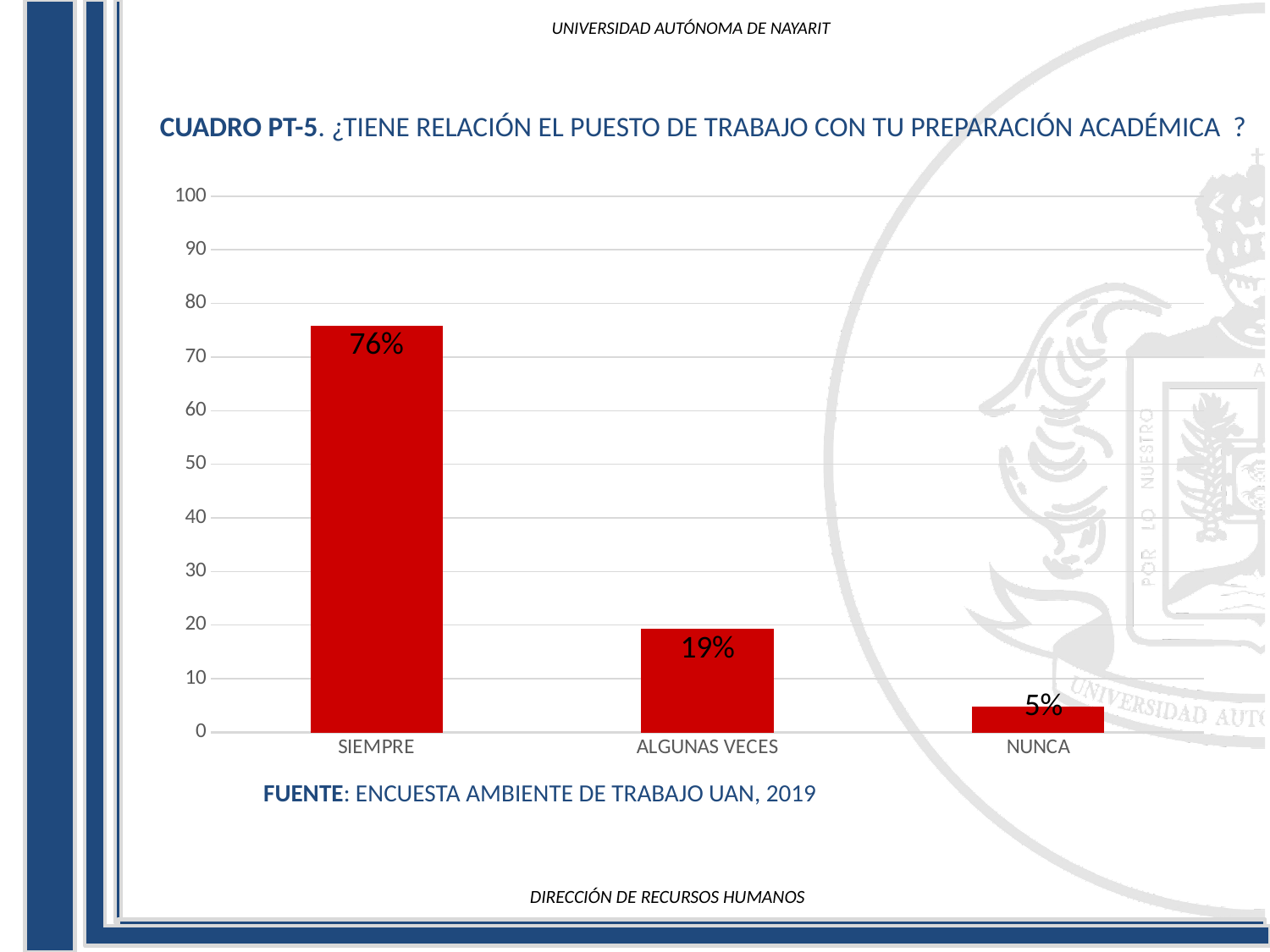
Is the value for SIEMPRE greater or less than 70? greater Do the values rise or fall from left to right along the x axis? fall What is the difference between the values for SIEMPRE and ALGUNAS VECES? 57% What is the value for NUNCA? 5% Which is larger, the value for ALGUNAS VECES or the value for NUNCA? ALGUNAS VECES What is the value for SIEMPRE? 76% What is the value for ALGUNAS VECES? 19% Which category has the lowest value? NUNCA What is the difference between the values for ALGUNAS VECES and NUNCA? 14% What kind of chart is shown on the slide? bar chart Which category has the highest value? SIEMPRE How many categories are shown on the x axis? 3